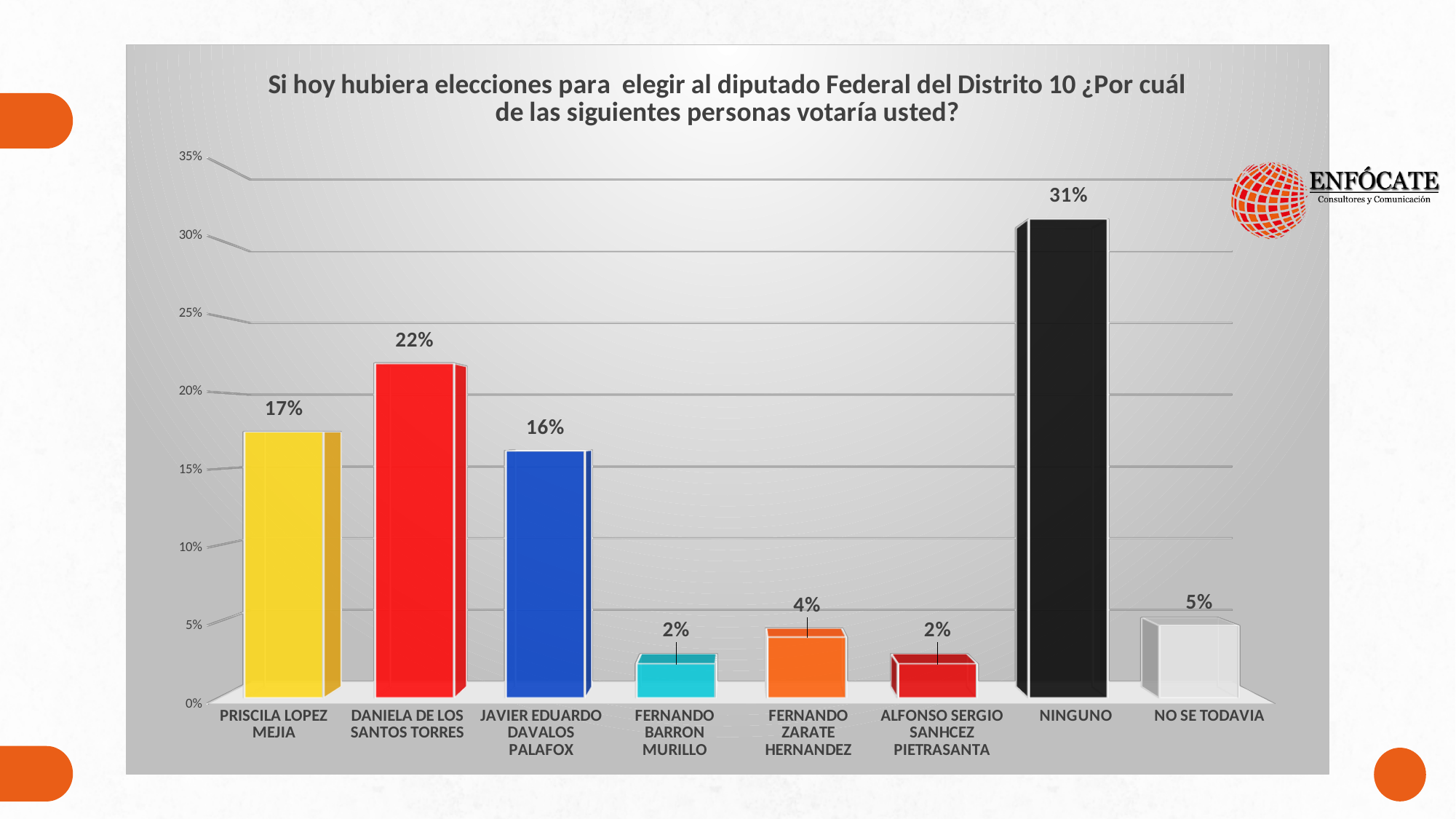
What percentage is shown for JAVIER EDUARDO DAVALOS PALAFOX? 16% Which category has the highest value? NINGUNO What percentage is shown for NO SE TODAVIA? 5% What percentage is shown for DANIELA DE LOS SANTOS TORRES? 22% What is the difference between the values for DANIELA DE LOS SANTOS TORRES and PRISCILA LOPEZ MEJIA? 5% What kind of chart is shown on the slide? bar chart What colour is the bar for NINGUNO? black Which candidate has the highest percentage among the named candidates? DANIELA DE LOS SANTOS TORRES Is the value for NINGUNO greater or less than 30%? greater Which is larger, the value for FERNANDO ZARATE HERNANDEZ or the value for NO SE TODAVIA? NO SE TODAVIA What percentage is shown for NINGUNO? 31% How many categories are shown on the x axis? 8